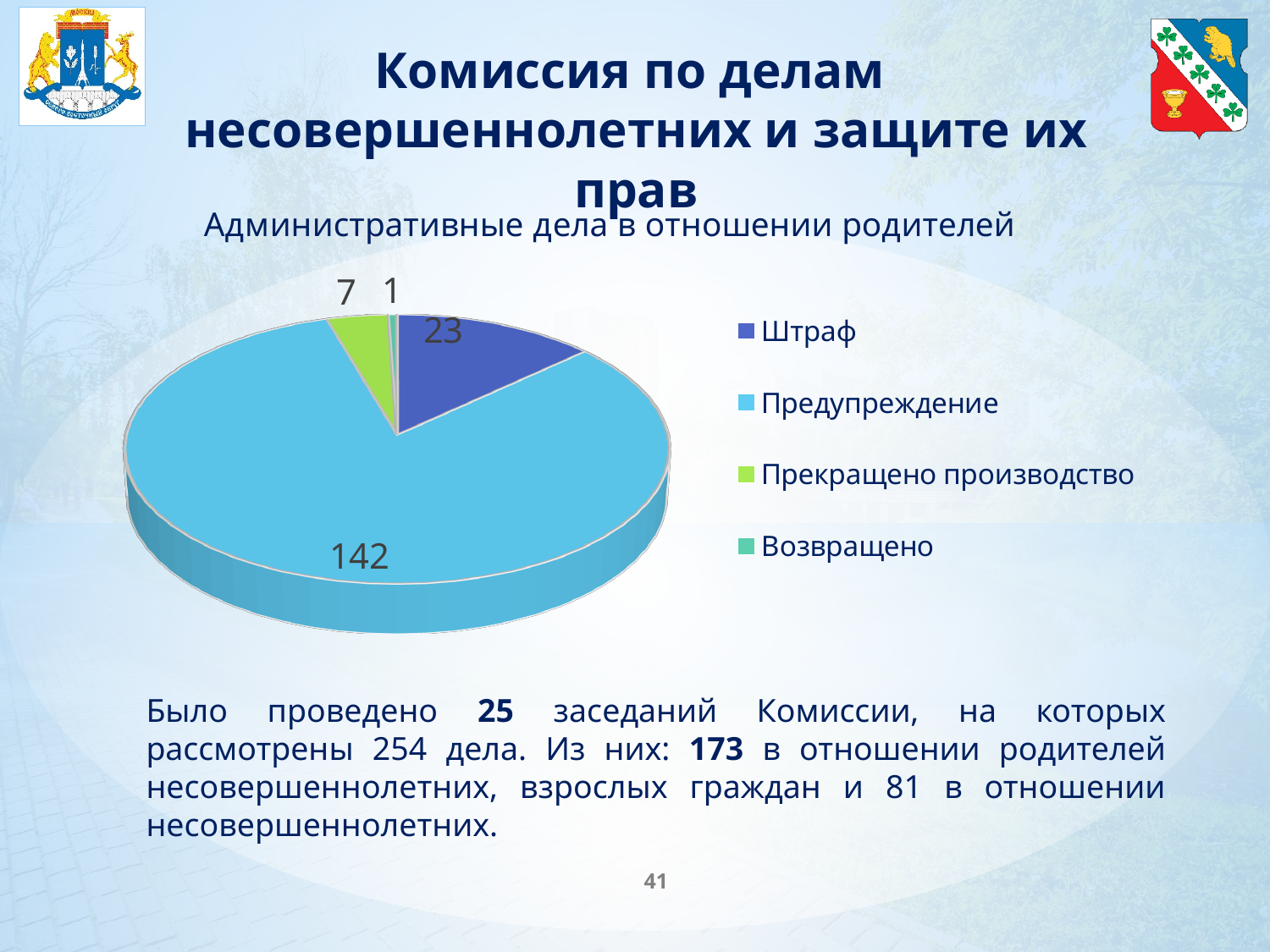
How many categories does the pie chart show? 4 What is the value for Предупреждение in the pie chart? 142 Which category has the largest slice in the pie chart? Предупреждение What is the value for Штраф in the pie chart? 23 What kind of chart is shown on the slide? Pie chart Which is larger, the value for Штраф or the value for Прекращено производство? Штраф What is the value for Возвращено in the pie chart? 1 What is the total of all the values shown in the pie chart? 173 What is the title of the chart? Административные дела в отношении родителей What is the difference between the values for Предупреждение and Штраф? 119 What is the value for Прекращено производство in the pie chart? 7 Which category has the smallest slice in the pie chart? Возвращено